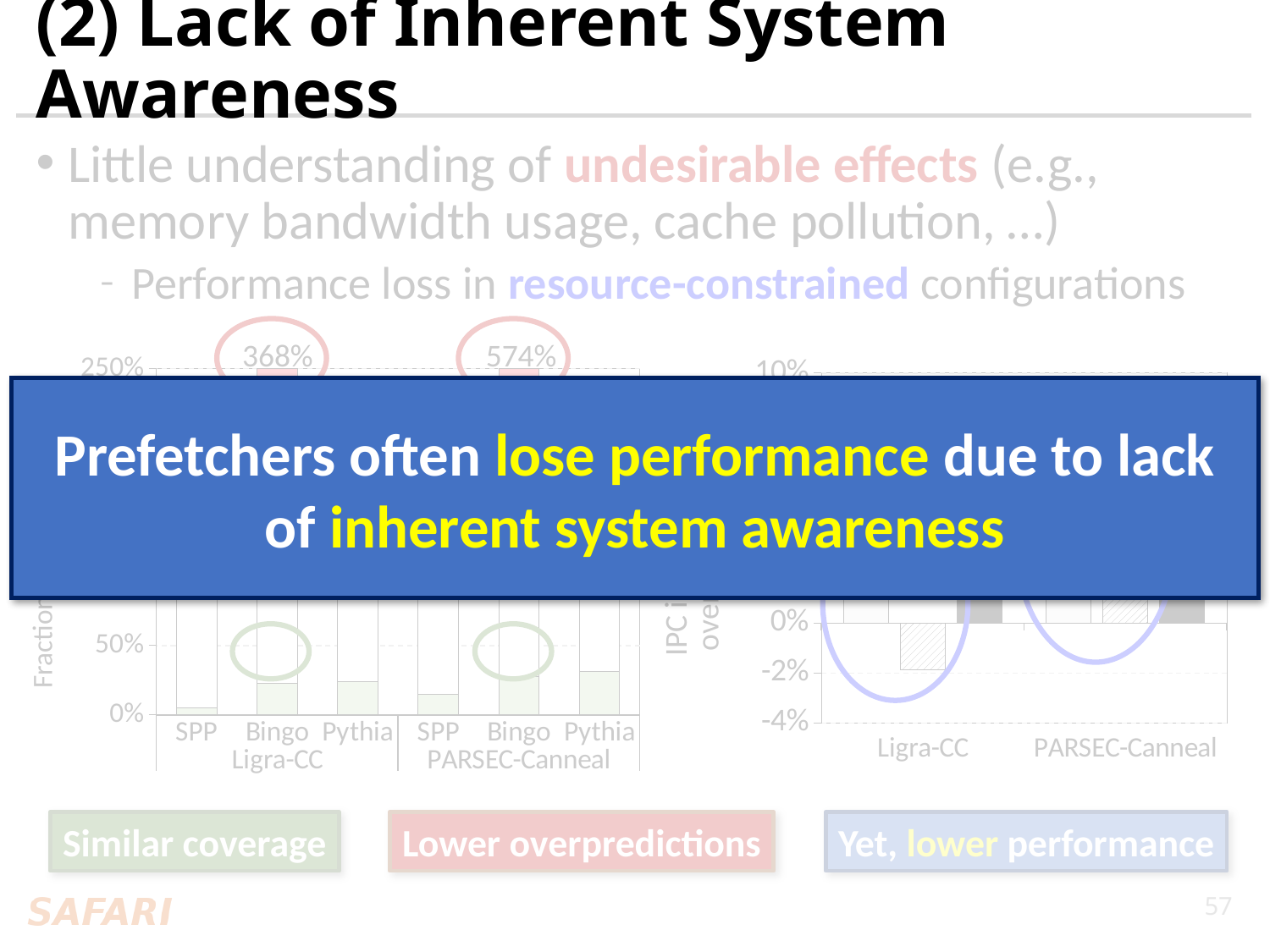
In the right chart, how many workload groups are shown on the x axis? 2 In the right chart, is the hatched bar for Ligra-CC greater or less than 0%? less In the left chart, what is the difference between the labeled Bingo values for PARSEC-Canneal (574%) and Ligra-CC (368%)? 206% What is the highest tick shown on the y axis of the right chart? 10% In the left chart, which labeled Bingo value is larger: Ligra-CC or PARSEC-Canneal? PARSEC-Canneal What kind of chart is the right chart? bar chart What kind of chart is the left chart? bar chart In the left chart, what value is labeled above the Bingo bar for Ligra-CC? 368% In the left chart, how many bars are plotted in total across both workload groups? 6 In the left chart, which three prefetchers are listed on the x axis for each workload? SPP, Bingo, Pythia In the left chart, what value is labeled above the Bingo bar for PARSEC-Canneal? 574%